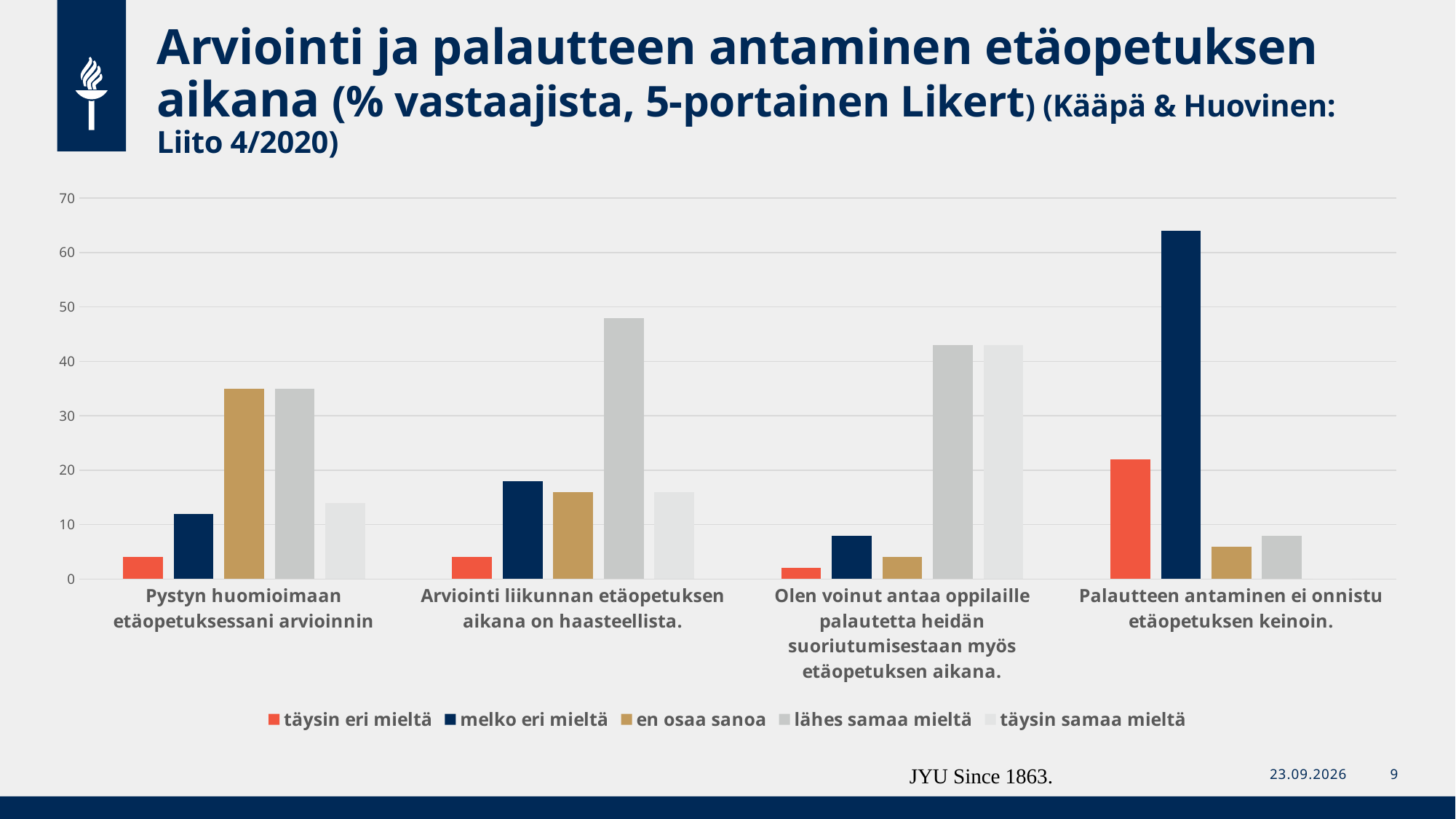
Is the 'melko eri mieltä' value for 'Palautteen antaminen ei onnistu etäopetuksen keinoin.' greater or less than 60? greater How many statement categories are shown on the x axis? 4 Is the 'en osaa sanoa' value for 'Pystyn huomioimaan etäopetuksessani arvioinnin' greater or less than 30? greater What kind of chart is shown on the slide? bar chart How many series does the legend list? 5 For 'Arviointi liikunnan etäopetuksen aikana on haasteellista.', which series has the highest bar? lähes samaa mieltä For 'Olen voinut antaa oppilaille palautetta heidän suoriutumisestaan myös etäopetuksen aikana.', which series has the lowest bar? täysin eri mieltä What colour represents 'täysin eri mieltä' in the legend? red/orange For which statement is the 'melko eri mieltä' bar the highest? Palautteen antaminen ei onnistu etäopetuksen keinoin. Is the 'lähes samaa mieltä' value for 'Arviointi liikunnan etäopetuksen aikana on haasteellista.' greater or less than 40? greater For 'Pystyn huomioimaan etäopetuksessani arvioinnin', which is larger: 'en osaa sanoa' or 'täysin samaa mieltä'? en osaa sanoa